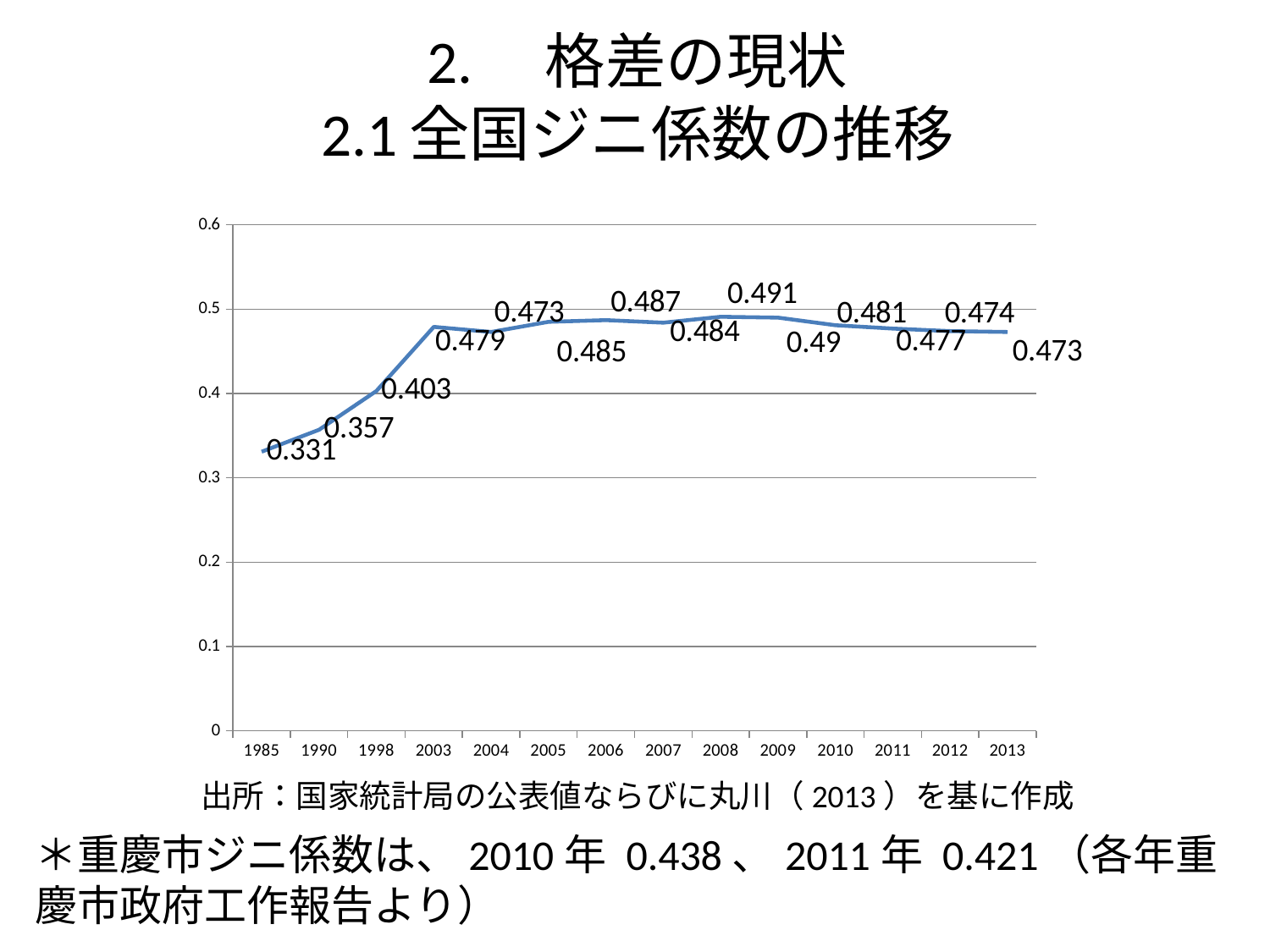
What is the Gini coefficient value for 2008? 0.491 What is the difference between the Gini coefficient in 2003 and in 1985? 0.148 Does the Gini coefficient rise or fall from 1985 to 2003? rise Is the Gini coefficient for 1990 greater or less than 0.4? less Which year has the highest Gini coefficient on the chart? 2008 What is the Gini coefficient value for 1985? 0.331 How many years are plotted on the chart? 14 What is the Gini coefficient value for 1998? 0.403 Which year has the lowest Gini coefficient on the chart? 1985 What is the Gini coefficient value for 2013? 0.473 What kind of chart is shown on the slide? line chart Which is larger, the Gini coefficient in 2005 or in 2010? 2005